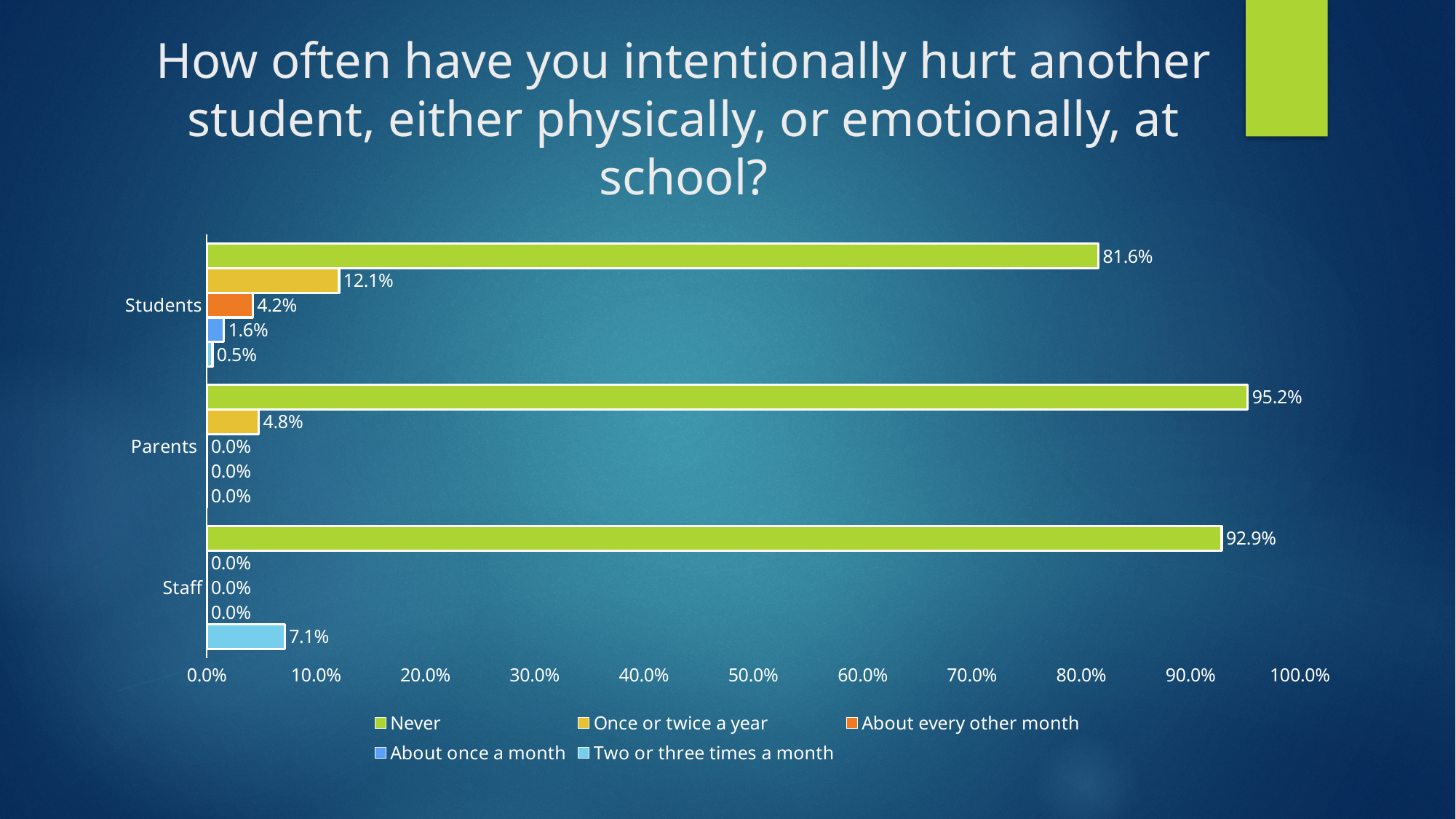
What kind of chart is shown on the slide? Bar chart What percentage of Parents answered "Once or twice a year"? 4.8% What percentage of Students answered "Never"? 81.6% What percentage of Staff answered "Two or three times a month"? 7.1% How many series does the legend list? 5 Which group has the lowest "Never" percentage? Students Which is larger: the "Once or twice a year" value for Students or for Parents? Students What colour are the "Never" bars? Green How many groups are shown on the y axis? 3 What percentage of Students answered "About every other month"? 4.2% What is the difference between the "Never" percentages for Parents and Students? 13.6% Which group has the highest "Never" percentage? Parents